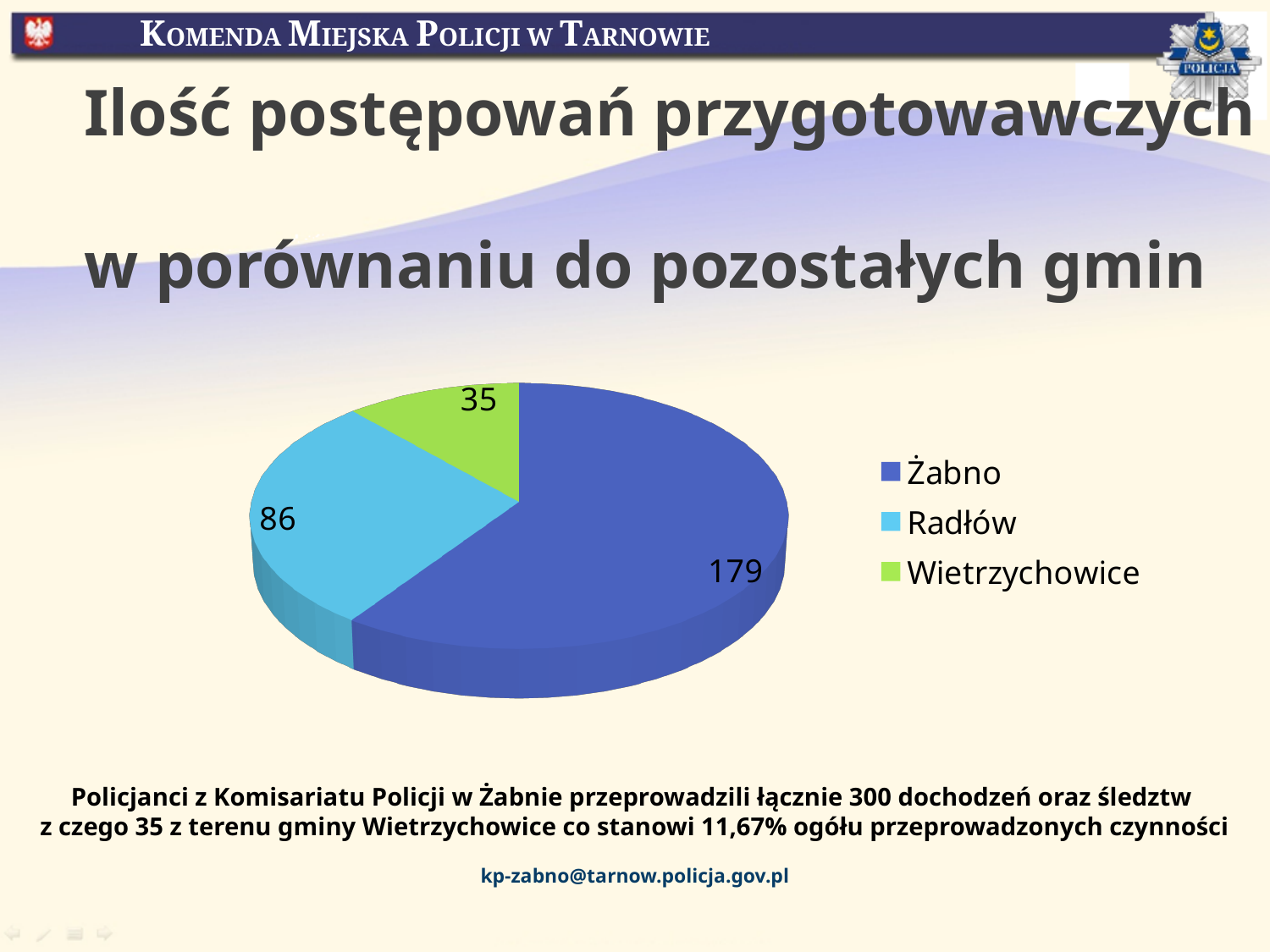
What is the value for Wietrzychowice in the pie chart? 35 Which is larger, the value for Radłów or the value for Wietrzychowice? Radłów Which colour represents Wietrzychowice in the legend? Green What is the total of all the values shown in the pie chart? 300 Which gmina has the smallest slice of the pie chart? Wietrzychowice What is the difference between the values for Radłów and Wietrzychowice? 51 Which gmina has the largest slice of the pie chart? Żabno What type of chart is shown on the slide? Pie chart What is the difference between the values for Żabno and Radłów? 93 How many slices does the pie chart have? 3 What is the value for Żabno in the pie chart? 179 What is the value for Radłów in the pie chart? 86